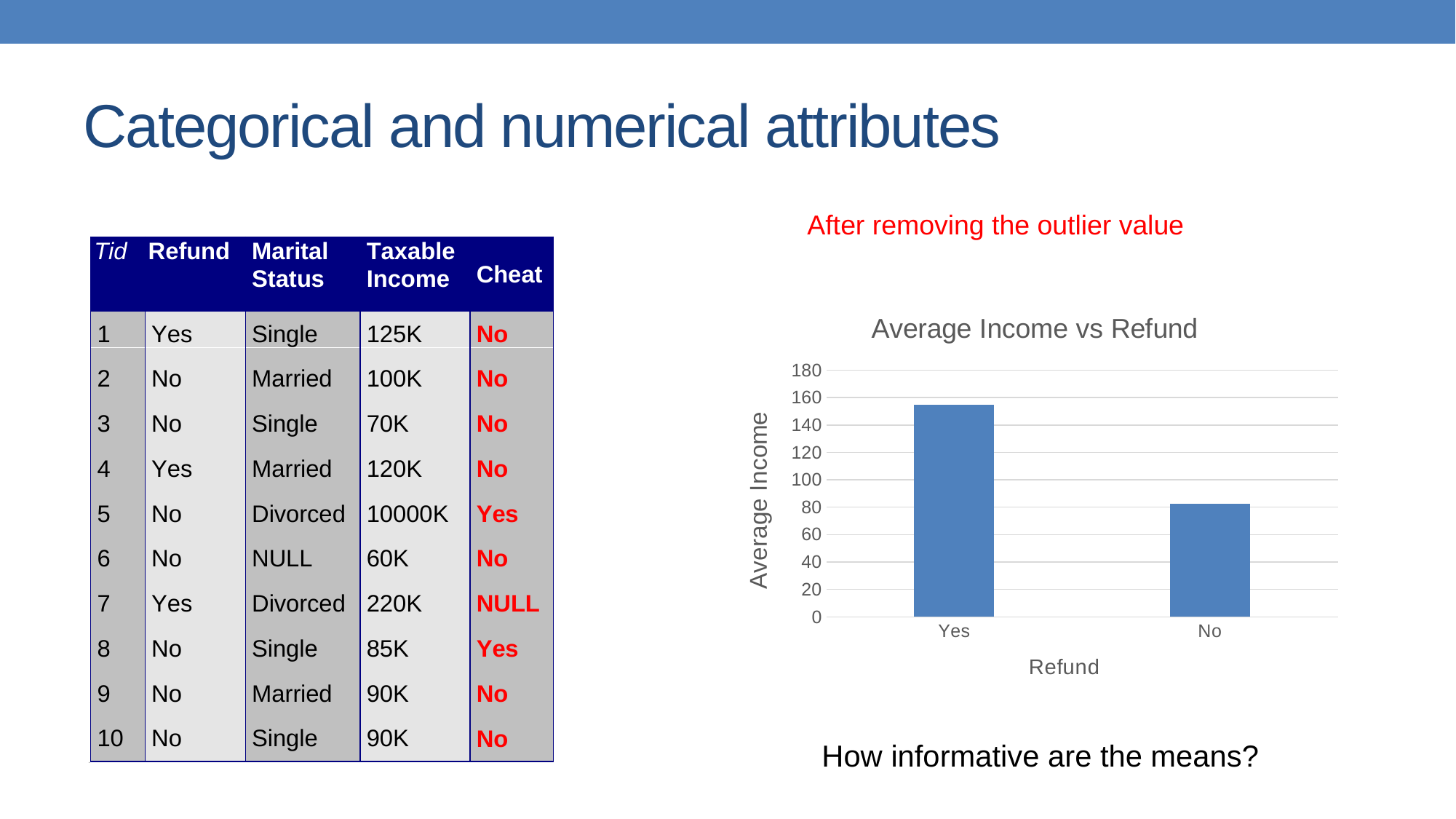
What kind of chart is shown on the slide? bar chart Do the bar values rise or fall moving from Yes to No along the x axis? fall Which Refund category has the lowest average income? No What is the label on the y axis of the chart? Average Income Which has a larger average income, Refund = Yes or Refund = No? Yes Is the average income for Refund = Yes greater or less than 160? less Is the average income for Refund = Yes greater or less than 140? greater Is the average income for Refund = No greater or less than 100? less How many categories are shown on the x axis of the Average Income vs Refund chart? 2 Which Refund category has the highest average income? Yes What is the title of the chart? Average Income vs Refund